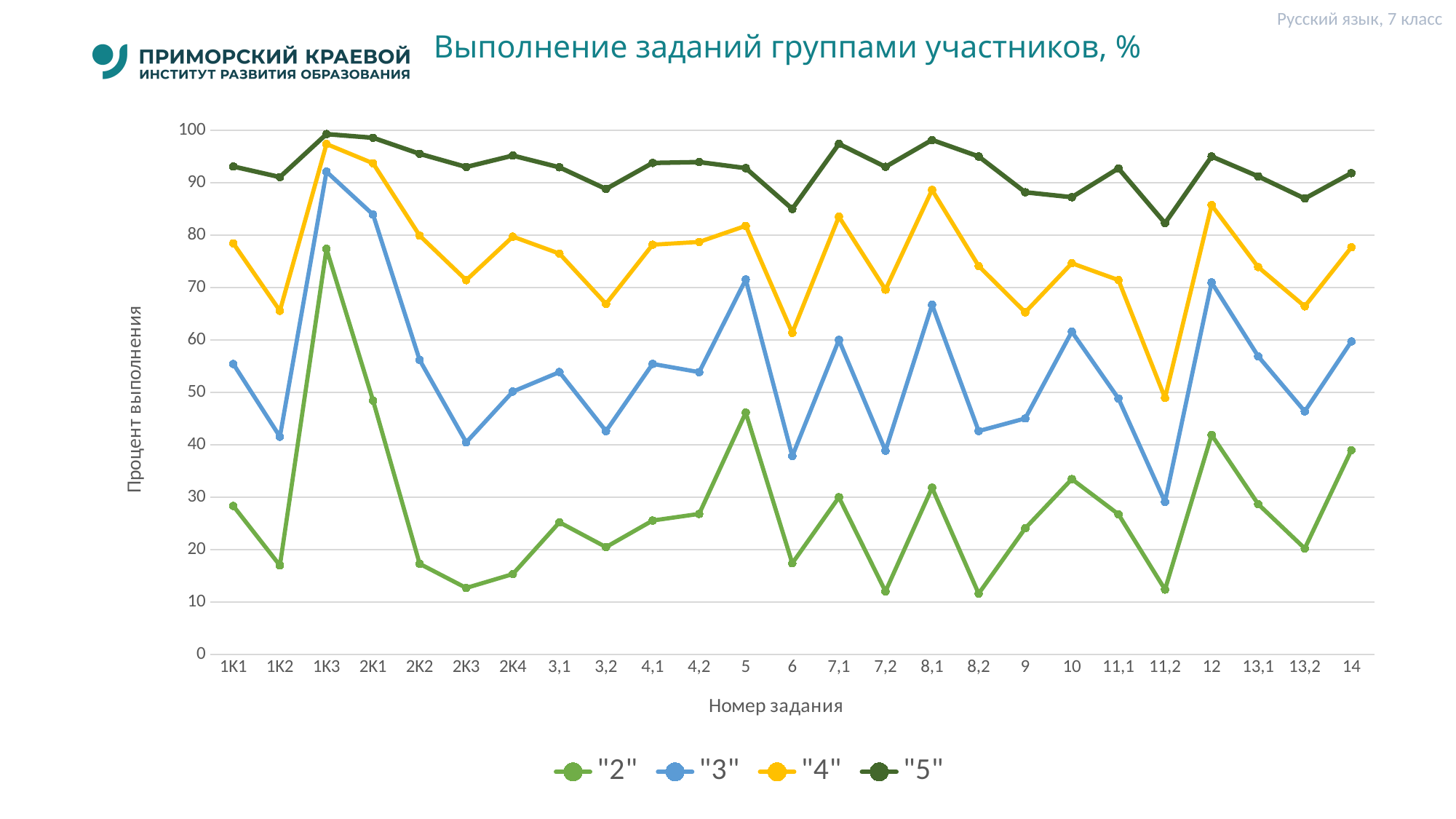
Is the value of the "2" series for task 1К3 greater or less than 70? greater Is the value of the "2" series for task 2К3 greater or less than 20? less For which task does the "4" series reach its lowest value? 11,2 What is the title of the chart? Выполнение заданий группами участников, % For which task does the "2" series reach its highest value? 1К3 Is the value of the "3" series for task 6 greater or less than 40? less For which task does the "3" series reach its lowest value? 11,2 What kind of chart is shown on the slide? line chart How many task numbers are shown along the x axis? 25 How many series does the legend list? 4 For the "3" series, which task has the larger value: 5 or 6? 5